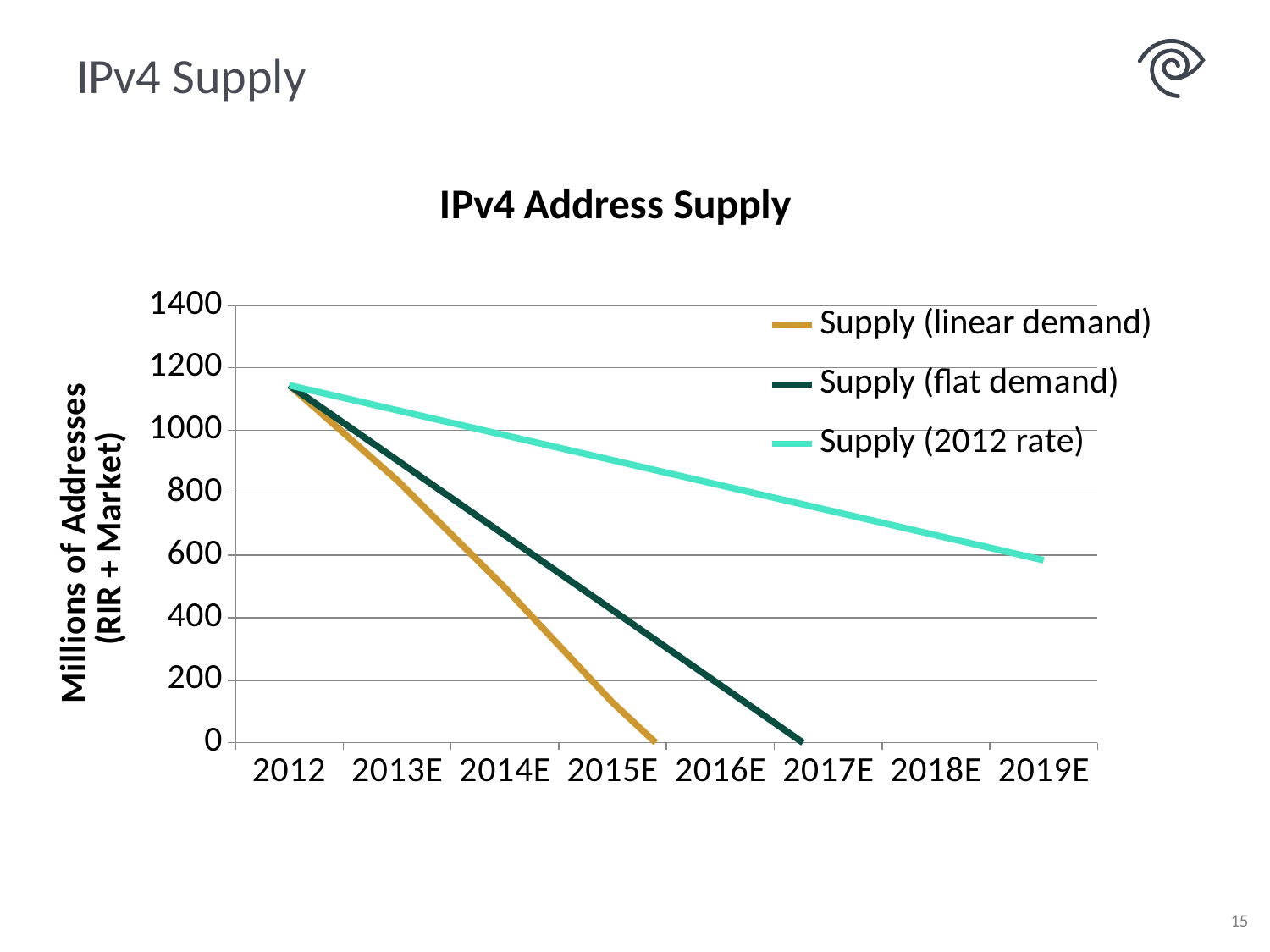
How many year categories are shown on the x axis? 8 Which series has the highest value at 2018E? Supply (2012 rate) Is the value for Supply (linear demand) at 2013E greater or less than 1000? less At 2015E, which is larger: Supply (flat demand) or Supply (linear demand)? Supply (flat demand) Is the value for Supply (2012 rate) at 2012 greater or less than 1000? greater Is the value for Supply (2012 rate) at 2018E greater or less than 600? greater How many series does the legend list? 3 Which series reaches zero first? Supply (linear demand) What is the title of the chart? IPv4 Address Supply Do the values for Supply (flat demand) rise or fall from 2012 onward? fall What kind of chart is shown on the slide? line chart